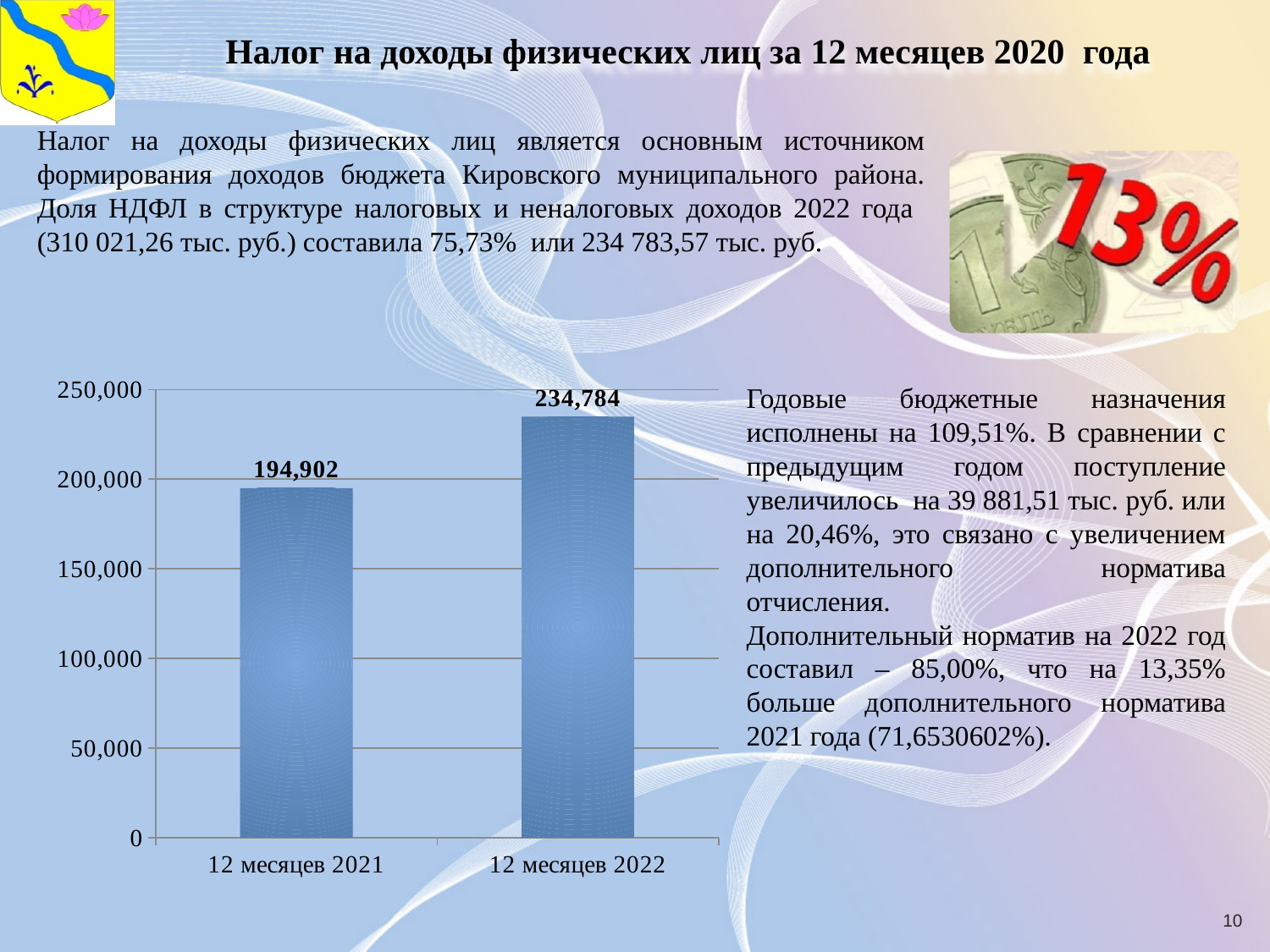
Is the value for 12 месяцев 2021 greater or less than 200,000? less What is the highest tick value shown on the vertical axis of the chart? 250,000 What is the difference between the values for 12 месяцев 2022 and 12 месяцев 2021? 39,882 What is the value for 12 месяцев 2022? 234,784 Do the values rise or fall from 12 месяцев 2021 to 12 месяцев 2022? rise Which category has the lowest value? 12 месяцев 2021 What is the value for 12 месяцев 2021? 194,902 Is the value for 12 месяцев 2022 greater or less than 200,000? greater How many categories are shown on the chart? 2 What kind of chart is shown on the slide? bar chart Which category has the highest value? 12 месяцев 2022 Which is larger, the value for 12 месяцев 2021 or for 12 месяцев 2022? 12 месяцев 2022